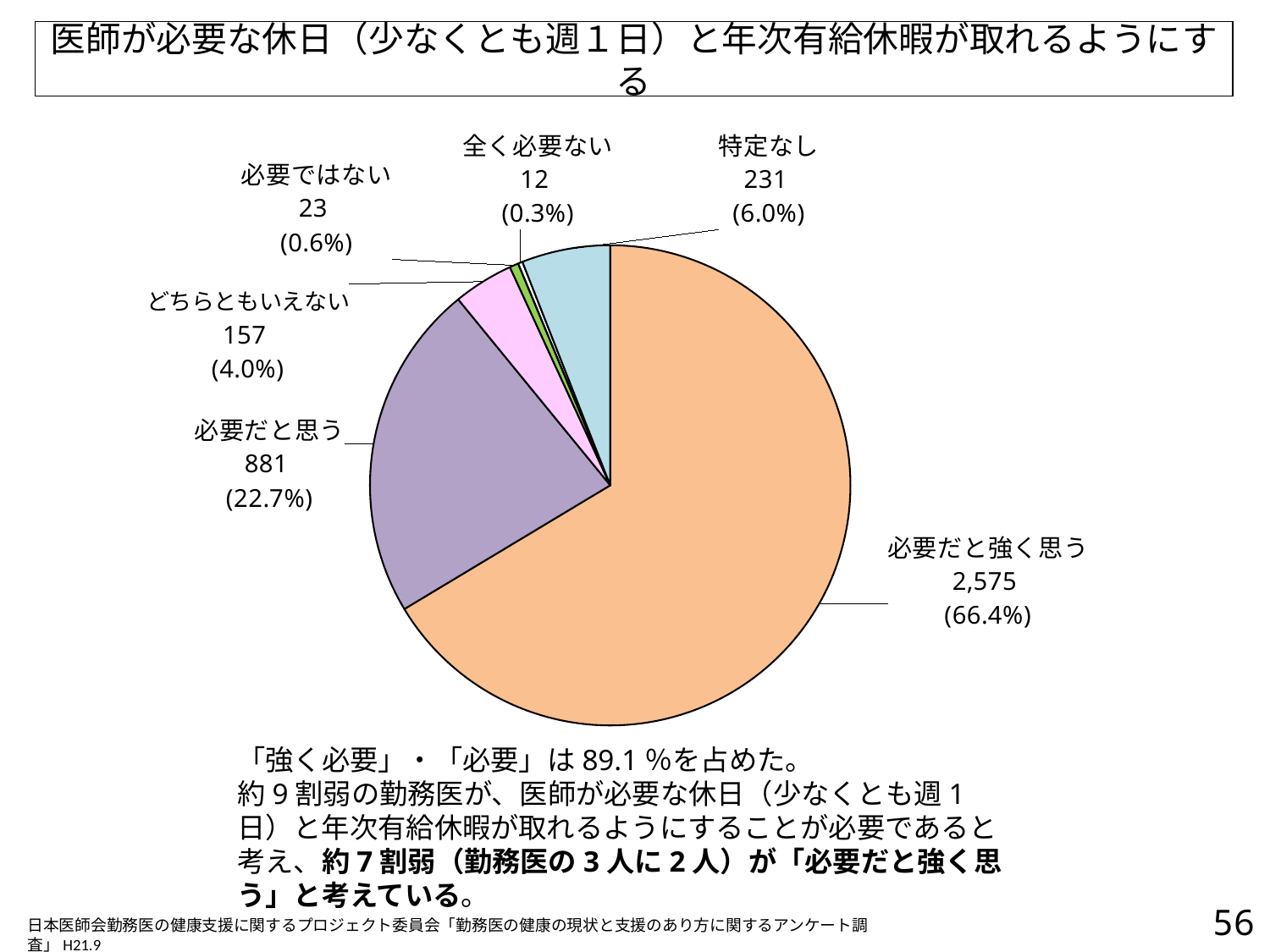
What percentage share does どちらともいえない have? 4.0% Which category has the largest slice? 必要だと強く思う What is the difference in count between 必要だと強く思う and 必要だと思う? 1,694 How many slices does the pie chart have? 6 What percentage share does 全く必要ない have? 0.3% What is the count for 特定なし? 231 Which is larger, the count for 特定なし or the count for どちらともいえない? 特定なし Which category has the smallest slice? 全く必要ない What percentage share does 必要だと思う have? 22.7% What is the count for 必要ではない? 23 What is the count for 必要だと強く思う? 2,575 What kind of chart is shown on the slide? pie chart